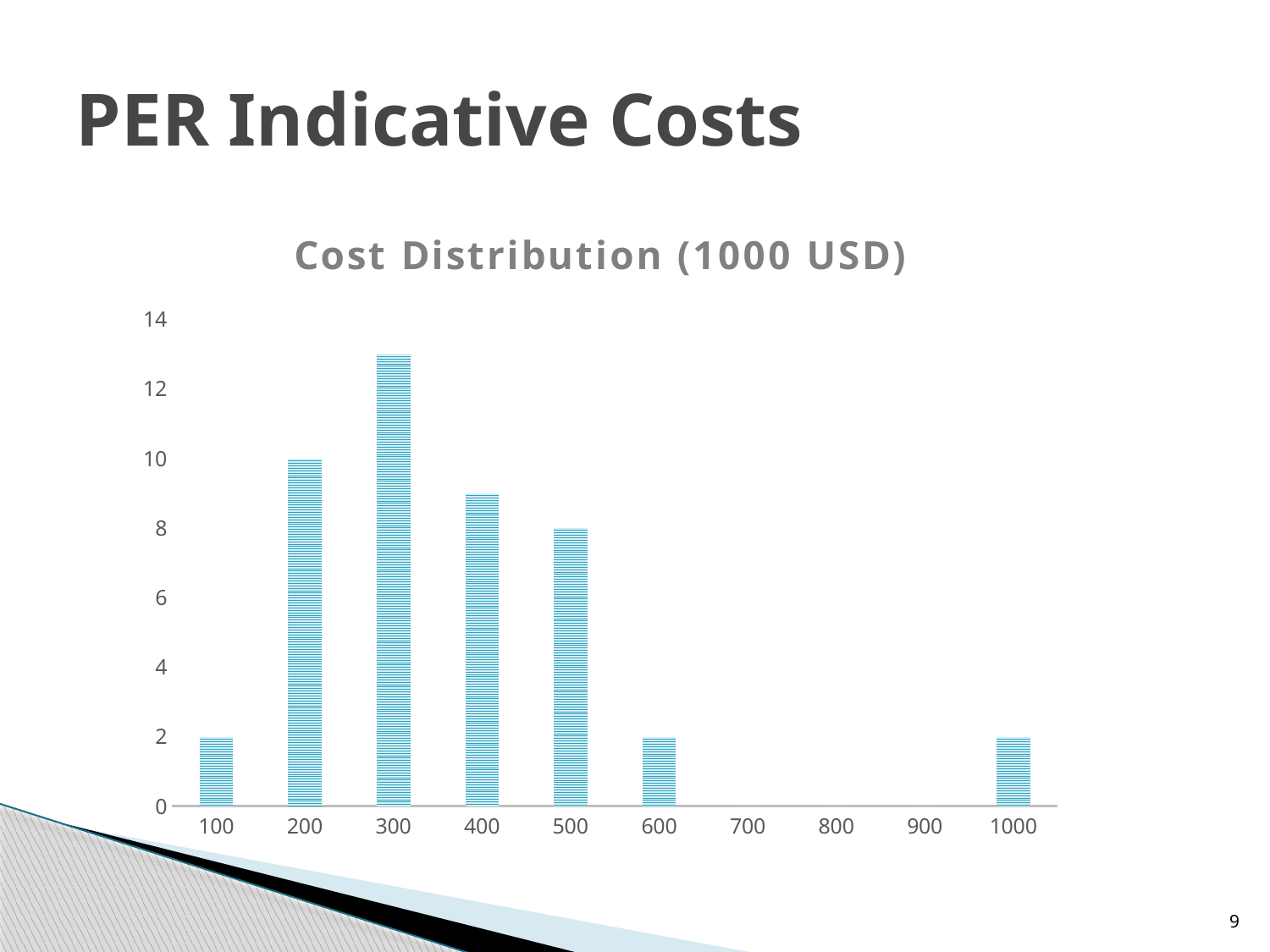
What type of chart is shown on the slide? bar chart What is the value for the 1000 category? 2 Which category has the highest value? 300 Is the value for 300 greater or less than 12? greater What is the value for the 200 category? 10 Which is larger, the value for 200 or the value for 500? 200 What is the value for the 100 category? 2 What is the value for the 500 category? 8 What is the difference between the value for 200 and the value for 500? 2 Is the value for 400 greater or less than 10? less What is the title of the chart? Cost Distribution (1000 USD) How many categories are shown on the x axis? 10